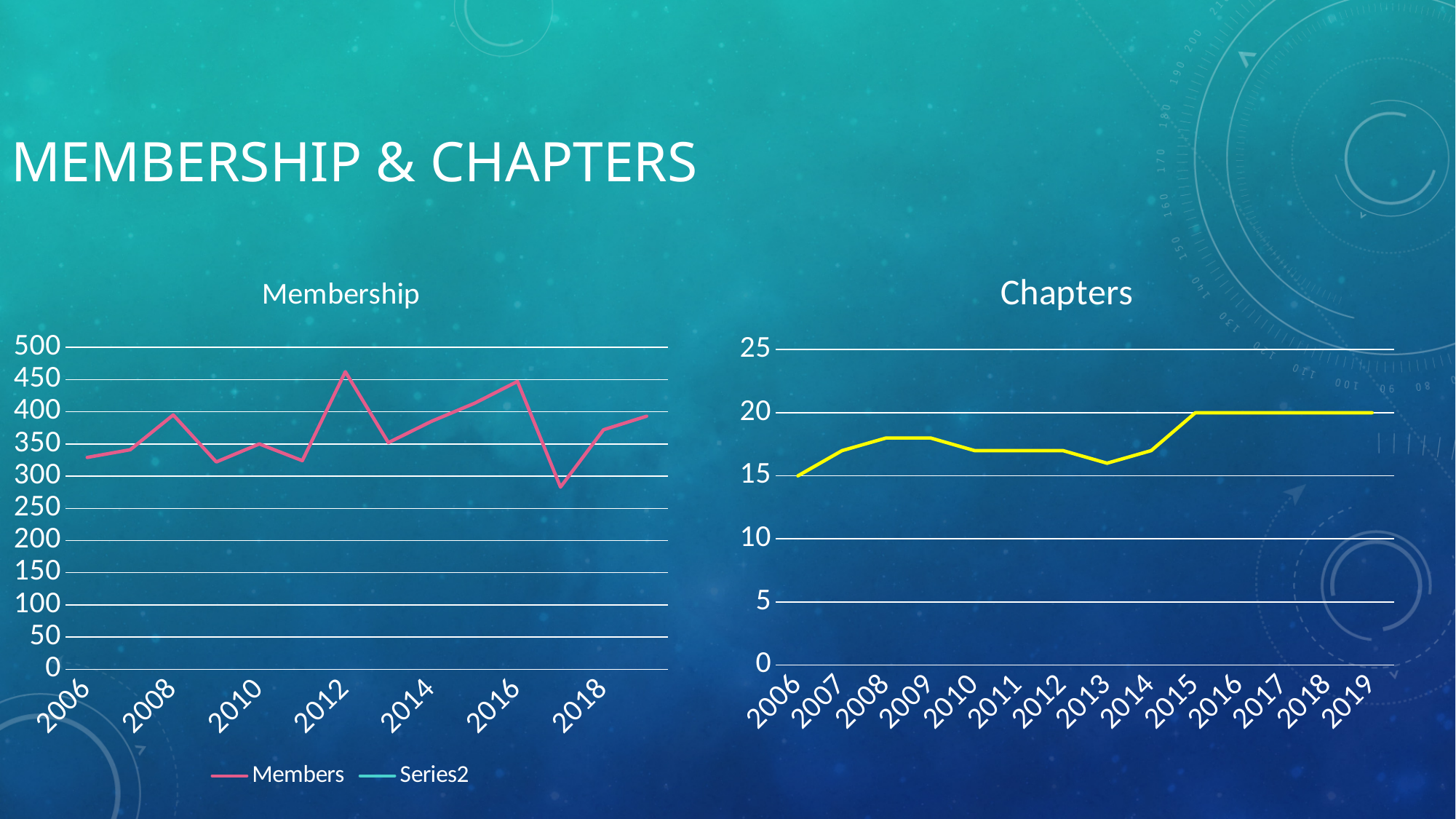
What kind of chart is the Chapters chart? line chart In the Membership chart, which year has the highest value? 2012 In the Chapters chart, do the values rise or fall overall from 2006 to 2019? rise How many series does the legend of the Membership chart list? 2 In the Chapters chart, what is the value for 2019? 20 In the Membership chart, is the value for 2017 greater or less than 300? less In the Chapters chart, which is larger, the value for 2015 or the value for 2013? 2015 In the Chapters chart, what is the difference between the values for 2019 and 2006? 5 In the Membership chart, which year has the lowest value? 2017 In the Chapters chart, what is the value for 2006? 15 How many years are labelled on the x axis of the Chapters chart? 14 What kind of chart is the Membership chart? line chart